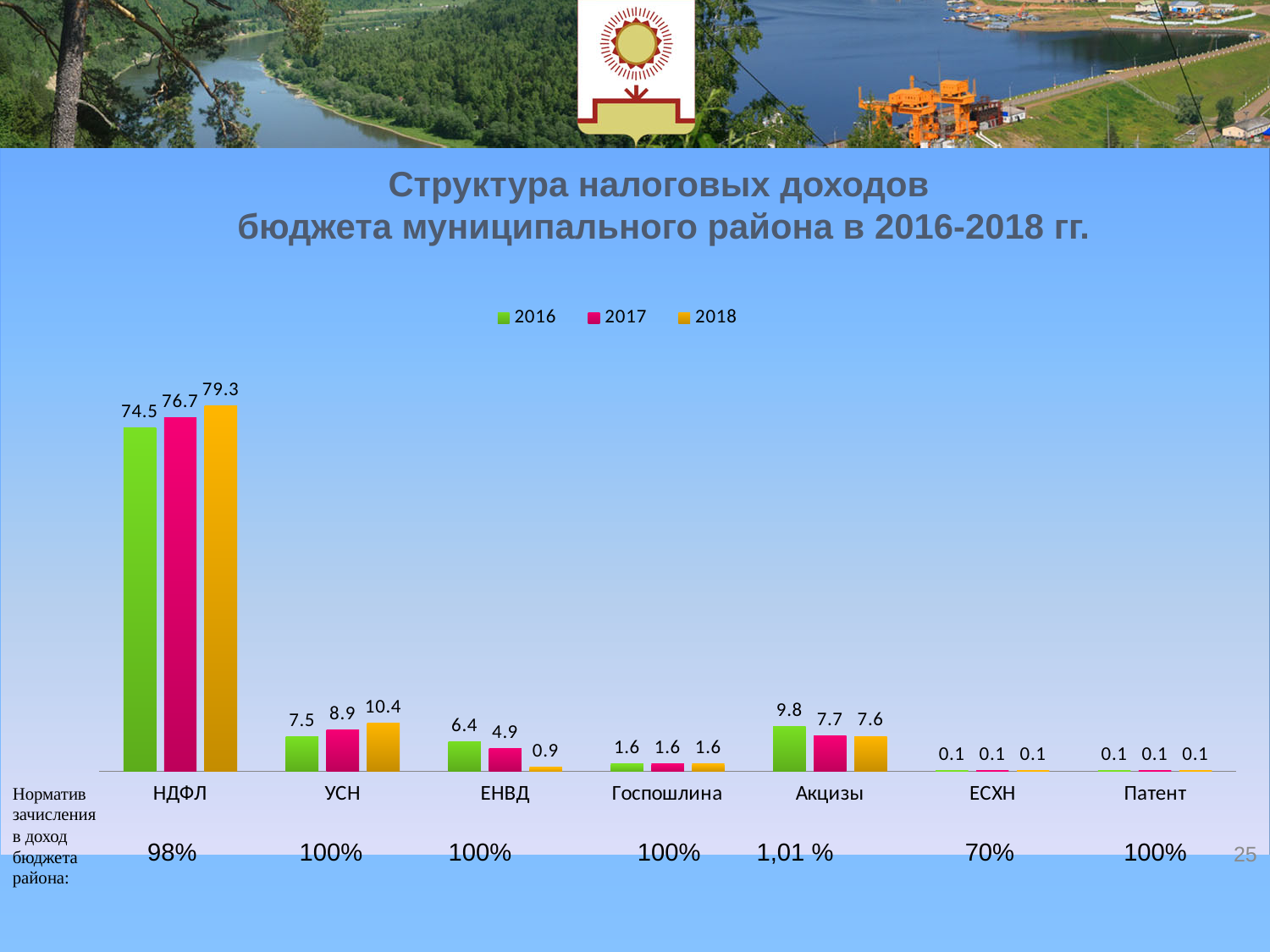
What is the value for УСН in 2016? 7.5 Which is larger, the 2016 value for Акцизы or the 2016 value for УСН? Акцизы What is the value for НДФЛ in 2018? 79.3 What is the difference between the 2018 and 2016 values for НДФЛ? 4.8 How many series does the legend list? 3 Do the values for ЕНВД rise or fall from 2016 to 2018? fall What is the value for ЕНВД in 2018? 0.9 What kind of chart is shown on the slide? bar chart Which category has the highest value in 2017? НДФЛ How many categories are shown on the x axis? 7 Which category has the lowest value in 2016, ЕСХН or Акцизы? ЕСХН What is the value for Акцизы in 2017? 7.7